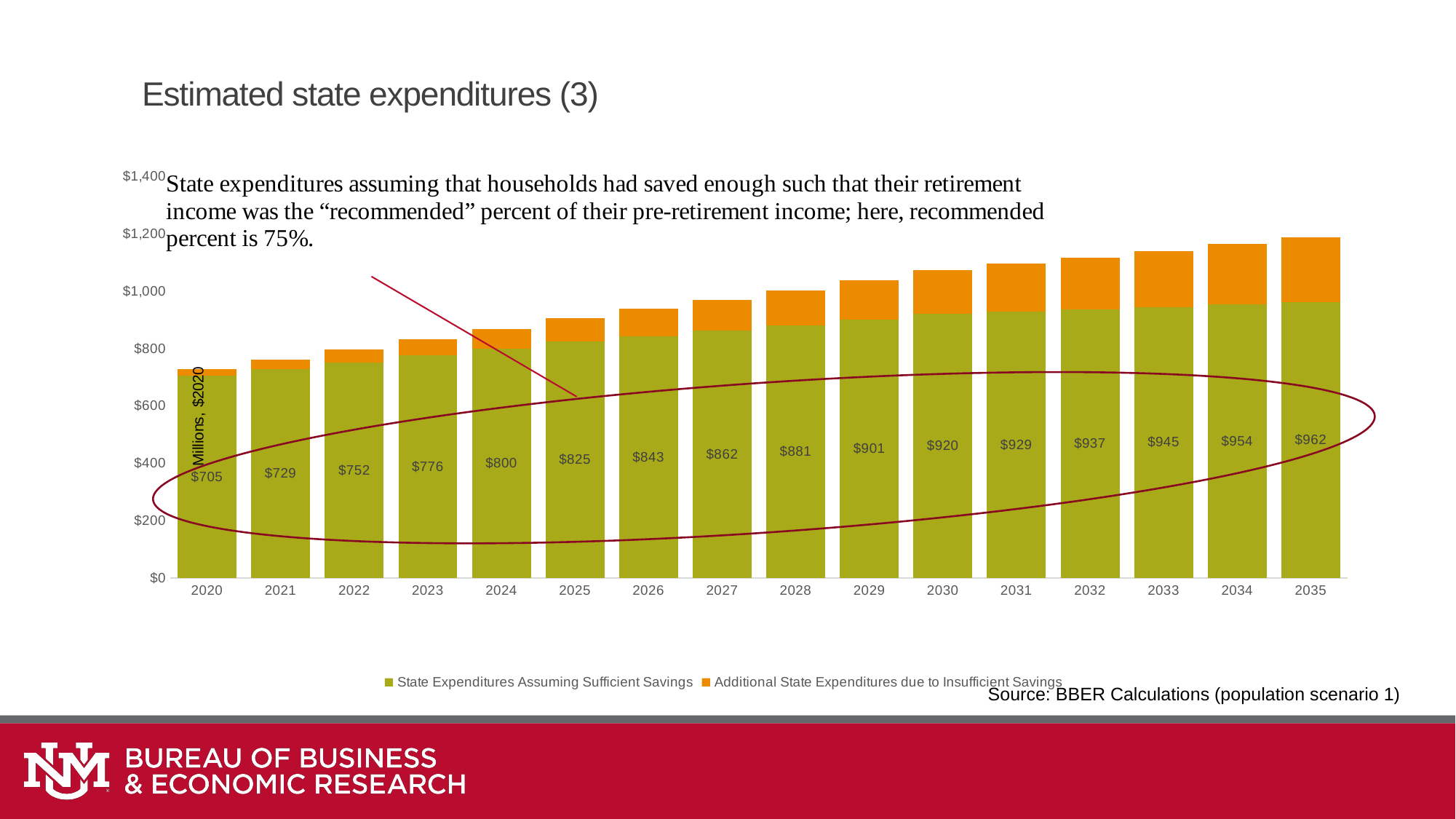
What is the difference between the State Expenditures Assuming Sufficient Savings values for 2035 and 2020? $257 Which year has the lowest value for State Expenditures Assuming Sufficient Savings? 2020 What is the value of State Expenditures Assuming Sufficient Savings for 2035? $962 Is the total stacked bar for 2035 greater or less than $1,000? greater How many series does the legend list? 2 How many years are shown on the x axis? 16 What is the value of State Expenditures Assuming Sufficient Savings for 2020? $705 What kind of chart is shown on the slide? Stacked bar chart Which is larger, the State Expenditures Assuming Sufficient Savings value for 2024 or for 2030? 2030 Do the State Expenditures Assuming Sufficient Savings values rise or fall from 2020 to 2035? Rise Which year has the highest value for State Expenditures Assuming Sufficient Savings? 2035 What is the value of State Expenditures Assuming Sufficient Savings for 2028? $881